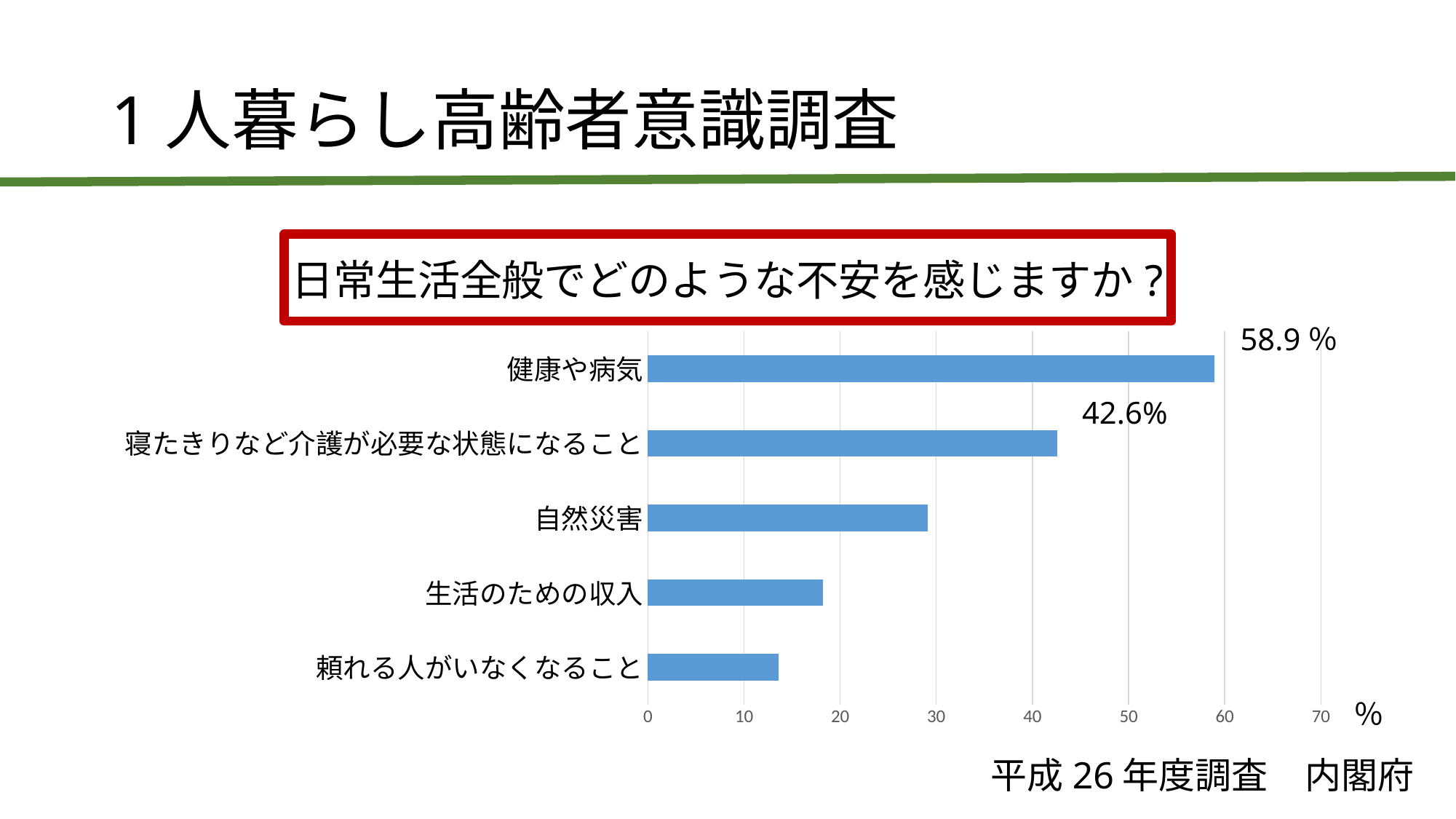
What is the difference between the values for 健康や病気 and 寝たきりなど介護が必要な状態になること? 16.3 What kind of chart is shown on the slide? bar chart How many categories are shown in the chart? 5 Is the value for 生活のための収入 greater or less than 20? less Which category has the lowest value? 頼れる人がいなくなること What is the value for 健康や病気? 58.9 % What is the value for 寝たきりなど介護が必要な状態になること? 42.6% Is the value for 頼れる人がいなくなること greater or less than 10? greater Is the value for 自然災害 greater or less than 20? greater Which is larger, the value for 自然災害 or the value for 生活のための収入? 自然災害 What question is shown in the red box above the chart? 日常生活全般でどのような不安を感じますか？ Which category has the highest value? 健康や病気